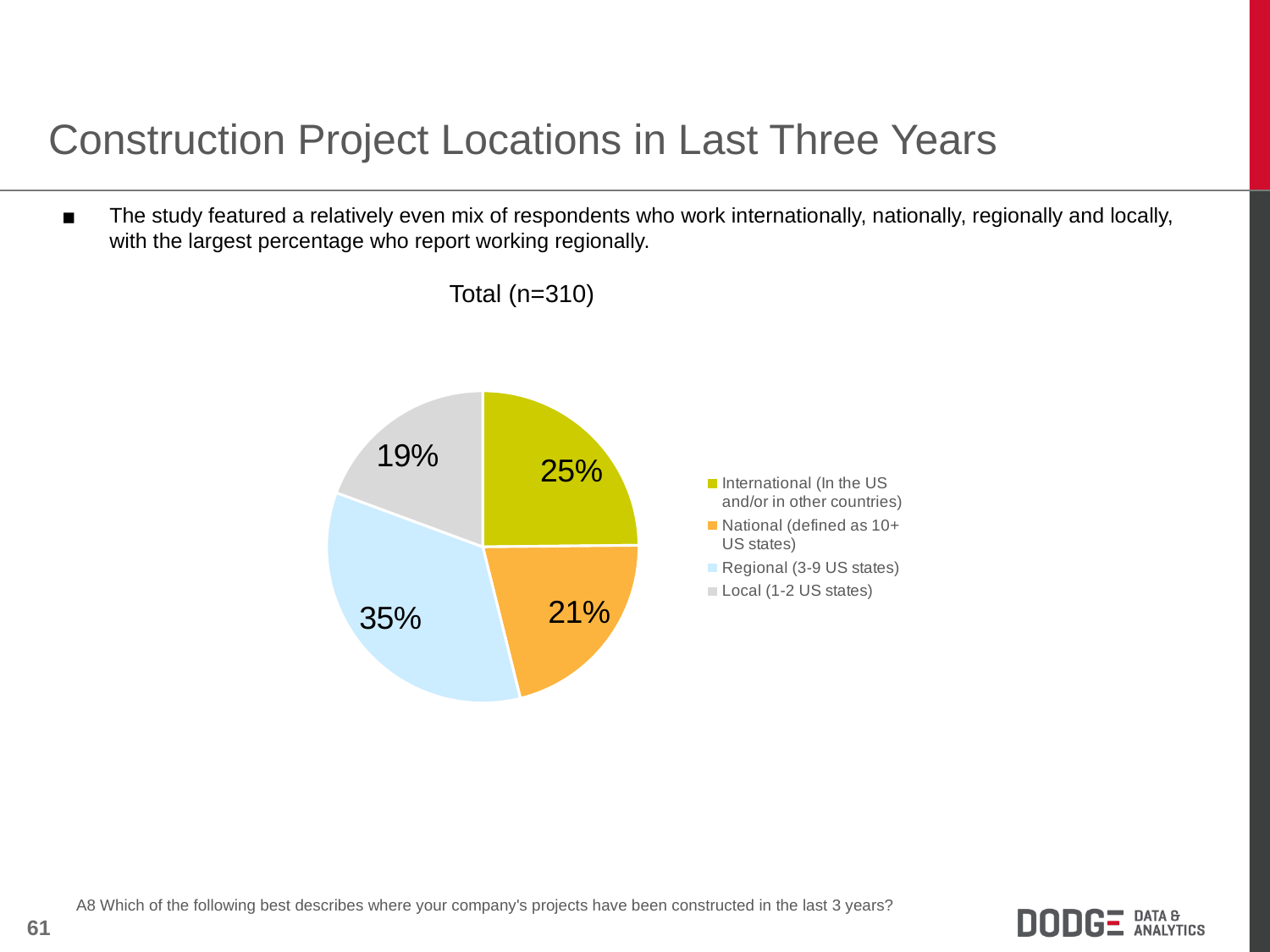
What type of chart is shown on the slide? Pie chart What is the title shown above the pie chart? Total (n=310) What percentage of respondents report working regionally (3-9 US states)? 35% What is the difference in percentage points between the Regional and Local slices? 16 Which project location category has the smallest share of respondents? Local (1-2 US states) What percentage of respondents report working nationally (defined as 10+ US states)? 21% Which project location category has the largest share of respondents? Regional (3-9 US states) How many slices does the pie chart have? 4 What percentage of respondents report working locally (1-2 US states)? 19% What percentage of respondents report working internationally (in the US and/or in other countries)? 25% Which colour represents the Regional (3-9 US states) slice? Light blue Which is larger, the International slice or the National slice? International